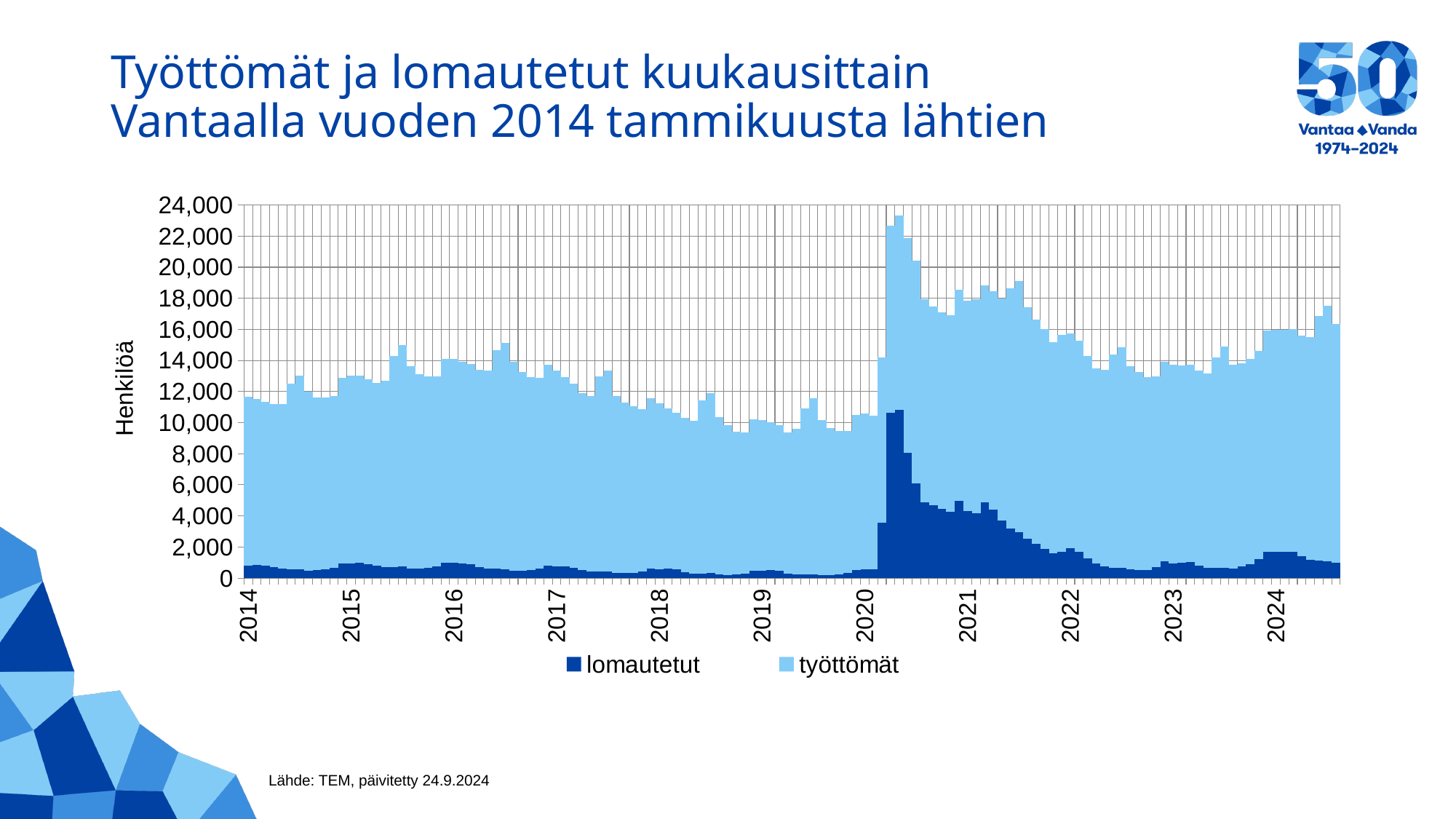
Which series is larger in most months, lomautetut or työttömät? työttömät Does the total rise or fall from the 2020 peak through 2022? fall What are the two series named in the legend? lomautetut and työttömät In which year does the total of the stacked bars reach its highest point? 2020 What is the label on the vertical axis? Henkilöä What kind of chart is shown on the slide? bar chart Is the peak value of lomautetut in 2020 greater or less than 10,000? greater How many series does the legend list? 2 Is the highest total reached in 2020 greater or less than 22,000? greater How many year labels are shown on the x axis? 11 Is the total at the start of 2014 greater or less than 10,000? greater